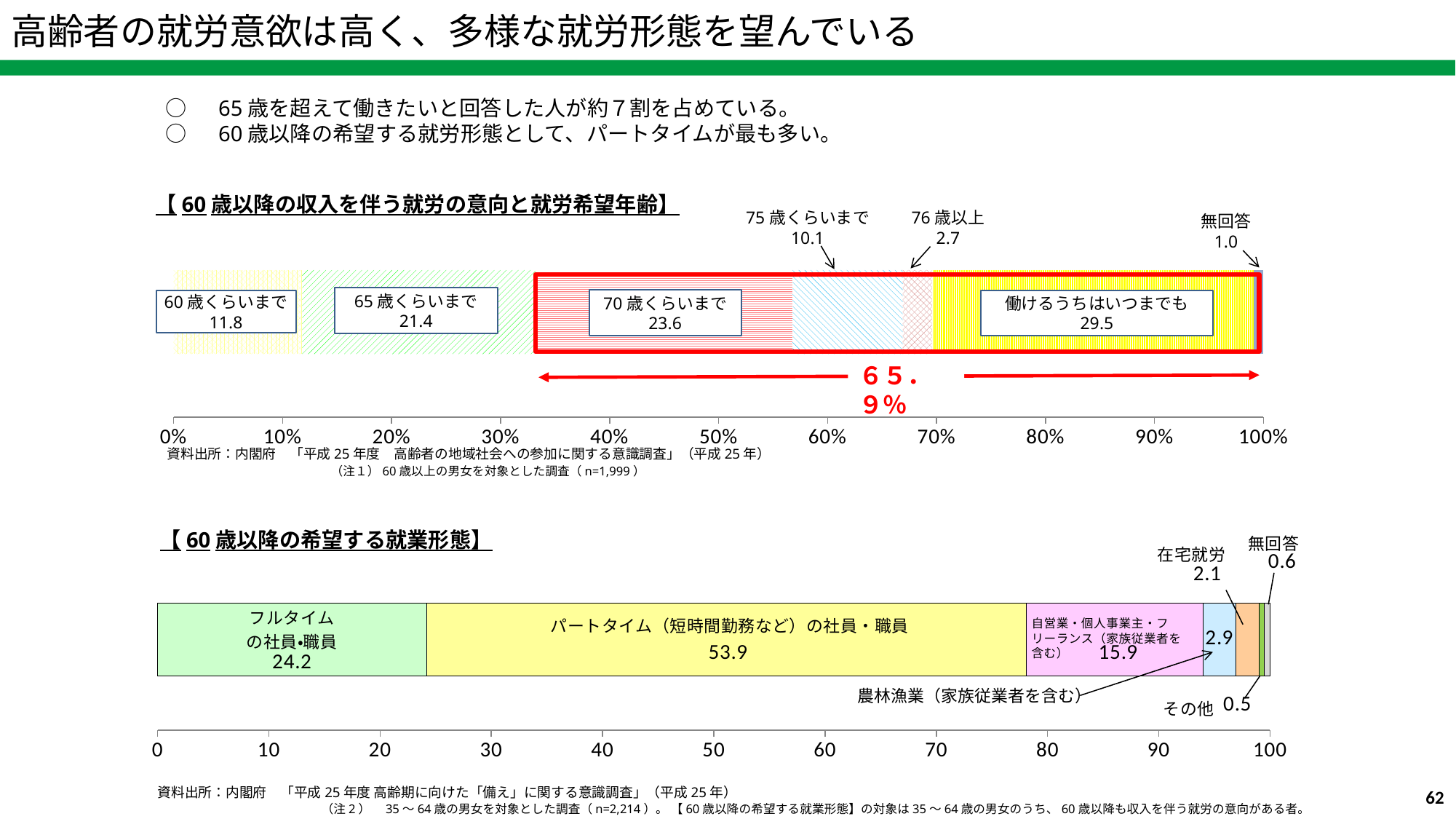
In the chart 【60歳以降の希望する就業形態】, which category has the lowest value? その他 In the chart 【60歳以降の希望する就業形態】, what is the value for パートタイム（短時間勤務など）の社員・職員? 53.9 In the chart 【60歳以降の希望する就業形態】, which is larger: フルタイムの社員・職員 or 自営業・個人事業主・フリーランス（家族従業者を含む）? フルタイムの社員・職員 In the chart 【60歳以降の収入を伴う就労の意向と就労希望年齢】, what percentage is shown by the red arrow annotation? 65.9% In the chart 【60歳以降の希望する就業形態】, what is the value for 在宅就労? 2.1 What type of chart is 【60歳以降の希望する就業形態】? Stacked horizontal bar chart In the chart 【60歳以降の希望する就業形態】, how many categories are shown? 7 In the chart 【60歳以降の収入を伴う就労の意向と就労希望年齢】, what is the value for 75歳くらいまで? 10.1 In the chart 【60歳以降の収入を伴う就労の意向と就労希望年齢】, which category has the highest value? 働けるうちはいつまでも In the chart 【60歳以降の収入を伴う就労の意向と就労希望年齢】, what is the difference between 70歳くらいまで and 65歳くらいまで? 2.2 In the chart 【60歳以降の収入を伴う就労の意向と就労希望年齢】, what is the value for 働けるうちはいつまでも? 29.5 In the chart 【60歳以降の収入を伴う就労の意向と就労希望年齢】, which category has the lowest value? 無回答